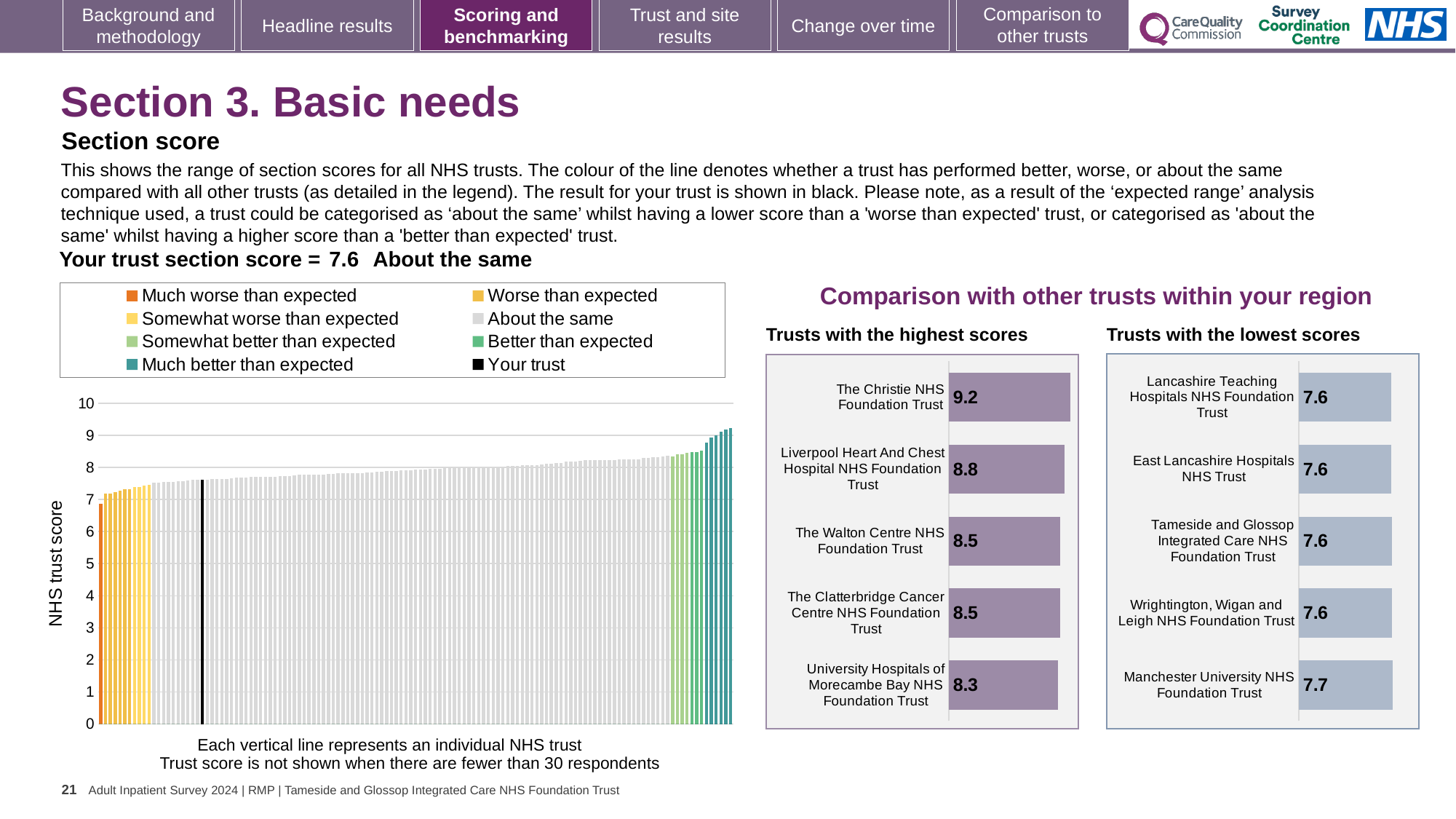
In the 'Trusts with the highest scores' chart, what is the difference between the scores of The Christie NHS Foundation Trust and Liverpool Heart And Chest Hospital NHS Foundation Trust? 0.4 In the 'Trusts with the lowest scores' chart, what is the score for Manchester University NHS Foundation Trust? 7.7 In the large 'NHS trust score' chart on the left, do the values rise or fall from left to right along the x axis? Rise What kind of chart is the large 'NHS trust score' chart on the left of the slide? Bar chart In the 'Trusts with the lowest scores' chart, which trust has the highest score? Manchester University NHS Foundation Trust In the 'Trusts with the highest scores' chart, which trust has the highest score? The Christie NHS Foundation Trust In the 'Trusts with the highest scores' chart, what is the score for The Christie NHS Foundation Trust? 9.2 In the 'Trusts with the lowest scores' chart, what is the score for Tameside and Glossop Integrated Care NHS Foundation Trust? 7.6 In the 'Trusts with the highest scores' chart, which trust has the lowest score? University Hospitals of Morecambe Bay NHS Foundation Trust In the 'Trusts with the highest scores' chart, how many trusts are shown? 5 How many entries does the legend of the large 'NHS trust score' chart on the left list? 8 Which is larger: the score for The Walton Centre NHS Foundation Trust in the highest scores chart or the score for Manchester University NHS Foundation Trust in the lowest scores chart? The Walton Centre NHS Foundation Trust